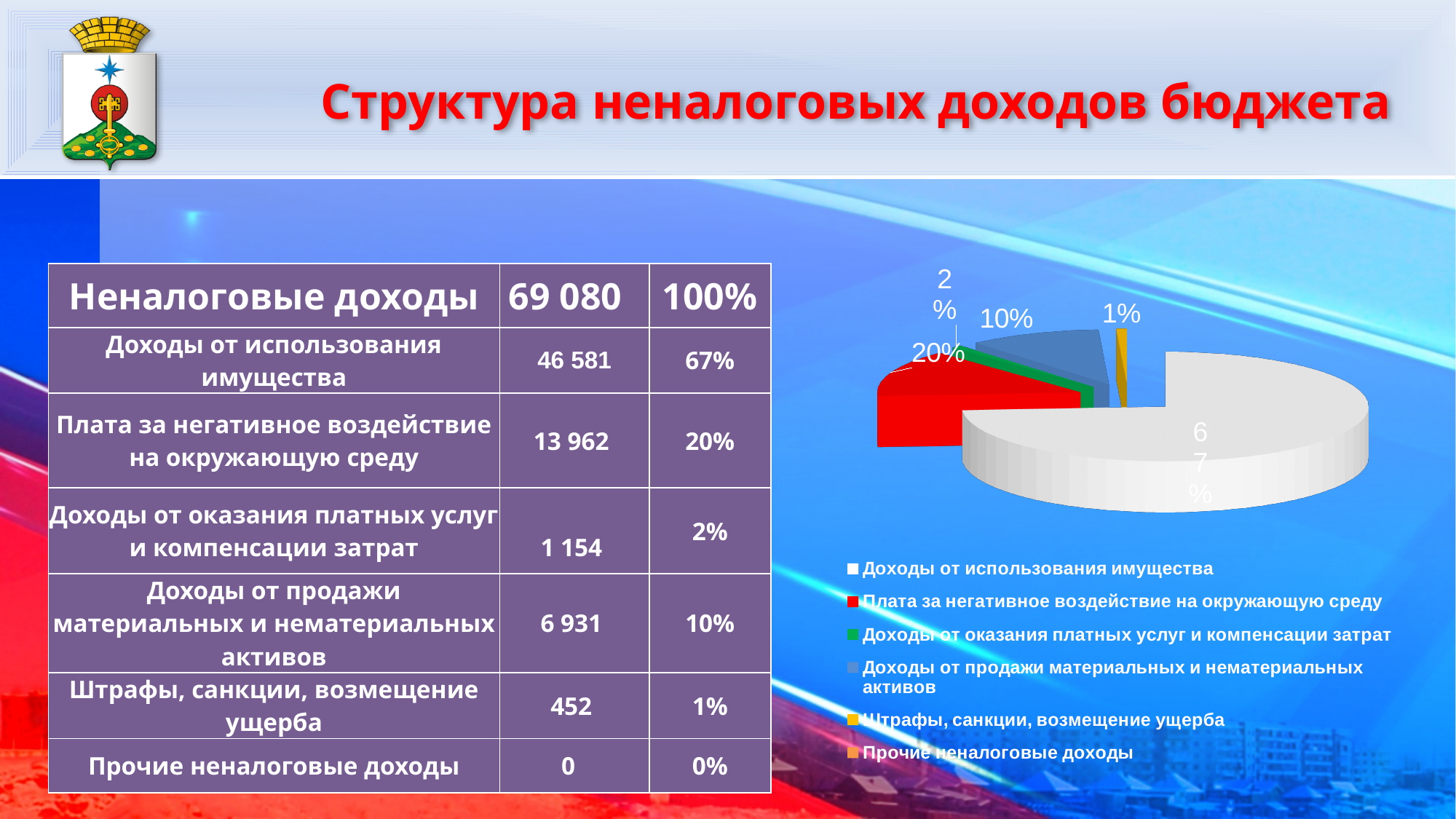
What percentage does the pie chart show for Доходы от использования имущества? 67% What percentage does the pie chart show for Доходы от оказания платных услуг и компенсации затрат? 2% How many categories does the pie chart legend list? 6 In the pie chart, which is larger: the share of Доходы от продажи материальных и нематериальных активов or the share of Доходы от оказания платных услуг и компенсации затрат? Доходы от продажи материальных и нематериальных активов Which category is shown in red in the pie chart? Плата за негативное воздействие на окружающую среду What type of chart is shown on the slide? Pie chart By how many percentage points does the share of Доходы от использования имущества exceed the share of Плата за негативное воздействие на окружающую среду in the pie chart? 47 What percentage does the pie chart show for Доходы от продажи материальных и нематериальных активов? 10% Which category has the largest slice in the pie chart? Доходы от использования имущества Which labelled slice in the pie chart has the smallest percentage? Штрафы, санкции, возмещение ущерба What percentage does the pie chart show for Штрафы, санкции, возмещение ущерба? 1% What percentage does the pie chart show for Плата за негативное воздействие на окружающую среду? 20%